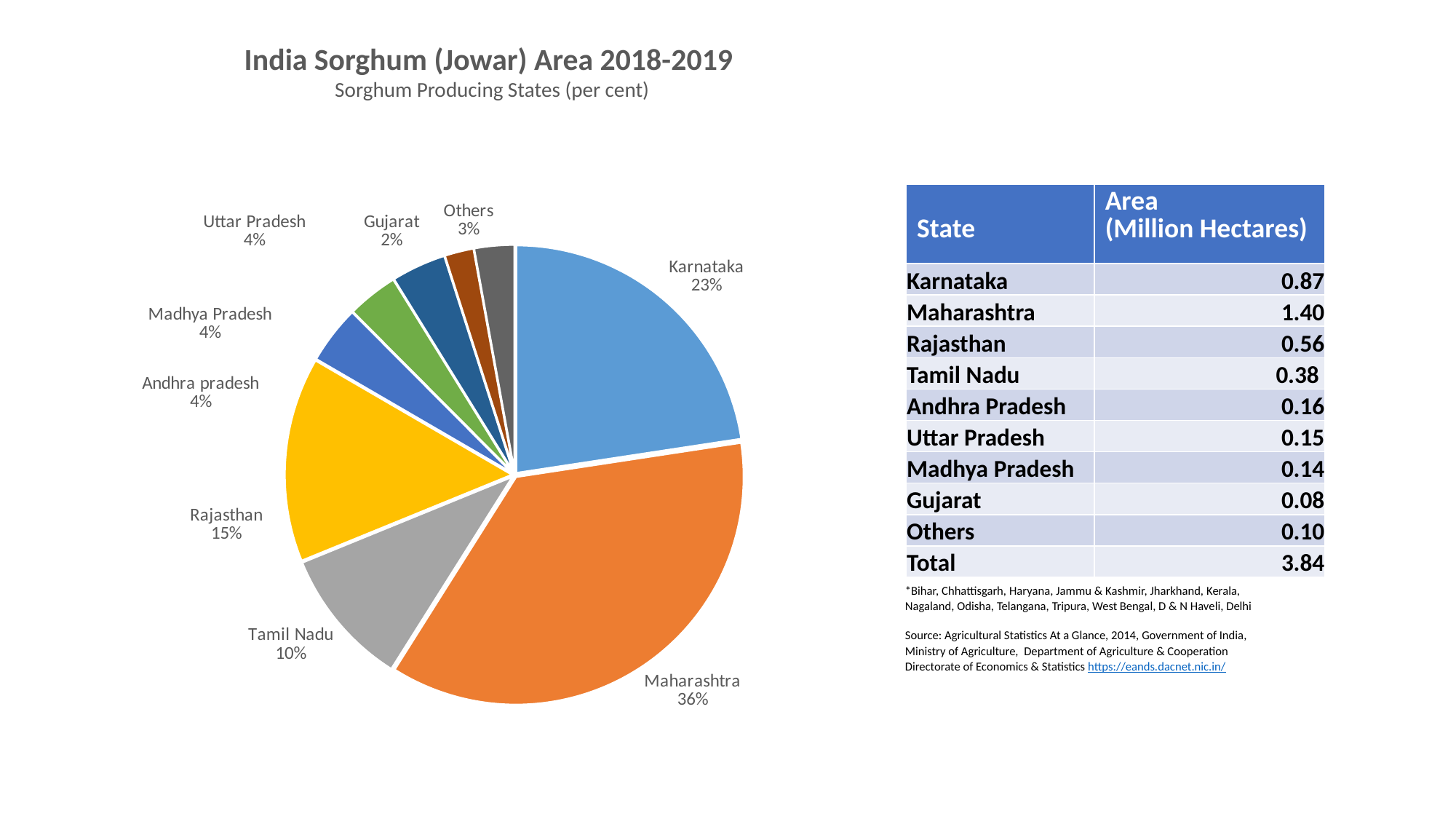
What share of the pie does Maharashtra hold? 36% Which state has the smallest slice of the pie? Gujarat What percentage is shown for Gujarat? 2% What percentage is shown for Rajasthan? 15% What type of chart is shown on the slide? pie chart How many slices does the pie chart have? 9 What is the title of the chart? India Sorghum (Jowar) Area 2018-2019 What share of the pie does Karnataka hold? 23% What is the difference in percentage points between Maharashtra and Karnataka? 13 What percentage is shown for Tamil Nadu? 10% Which has a larger share, Rajasthan or Tamil Nadu? Rajasthan Which state has the largest slice of the pie? Maharashtra